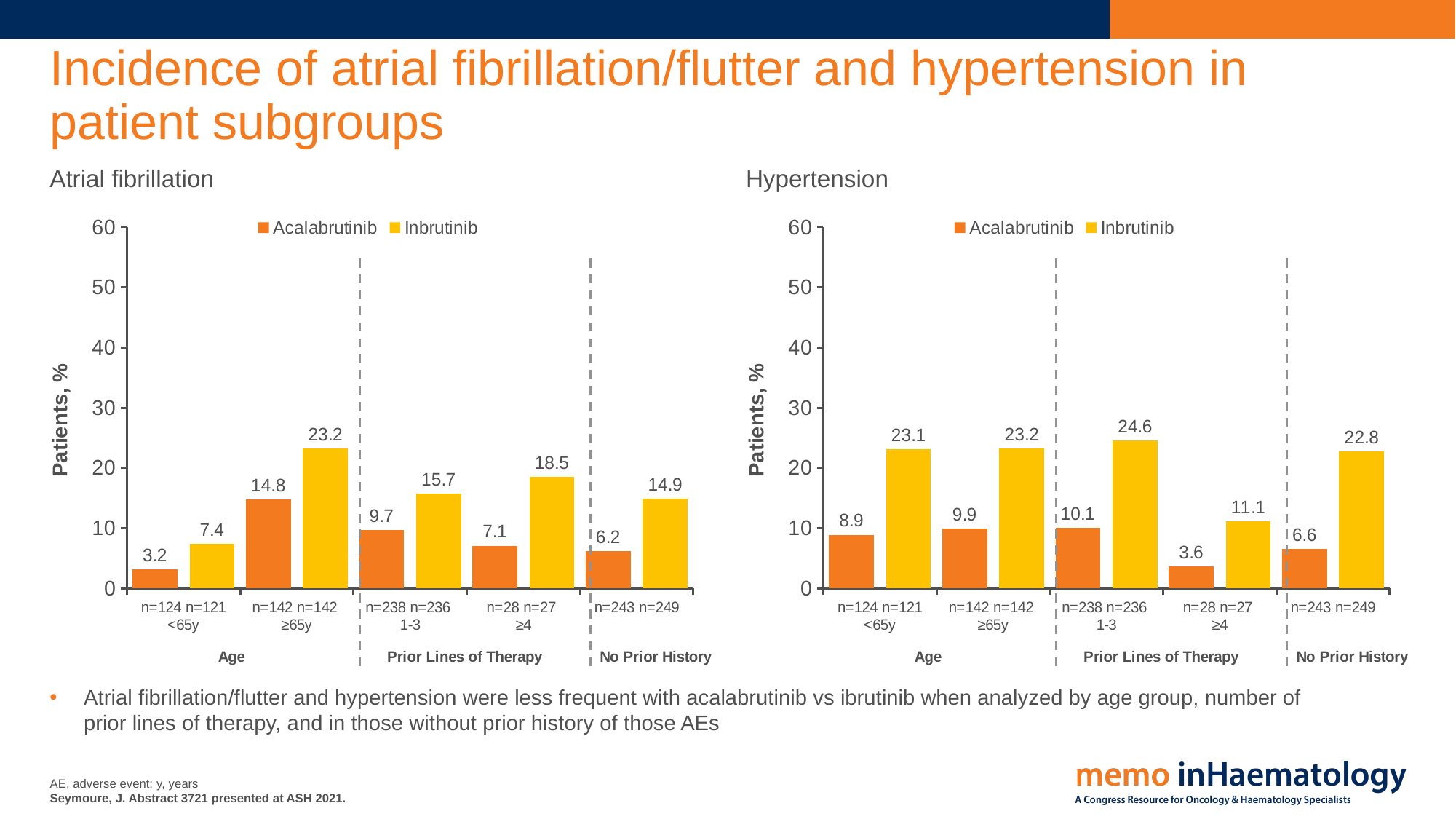
In the Hypertension chart, what is the value for Acalabrutinib in the ≥4 prior lines of therapy group? 3.6 In the Atrial fibrillation chart, what is the value for Ibrutinib in the ≥65y age group? 23.2 What kind of chart is the Atrial fibrillation chart? Bar chart In the Atrial fibrillation chart, which subgroup has the highest Ibrutinib value? ≥65y In the Hypertension chart, what is the difference between the Ibrutinib and Acalabrutinib values in the No Prior History group? 16.2 In the Atrial fibrillation chart, what is the difference between the Ibrutinib and Acalabrutinib values in the ≥65y age group? 8.4 What is the y-axis label of the Hypertension chart? Patients, % In the Atrial fibrillation chart, what is the value for Acalabrutinib in the <65y age group? 3.2 In the Hypertension chart, which subgroup has the lowest Acalabrutinib value? ≥4 In the Hypertension chart, what is the value for Ibrutinib in the 1-3 prior lines of therapy group? 24.6 In the Atrial fibrillation chart, which is larger for the ≥4 prior lines group: Acalabrutinib or Ibrutinib? Ibrutinib How many series does the legend of the Hypertension chart list? 2